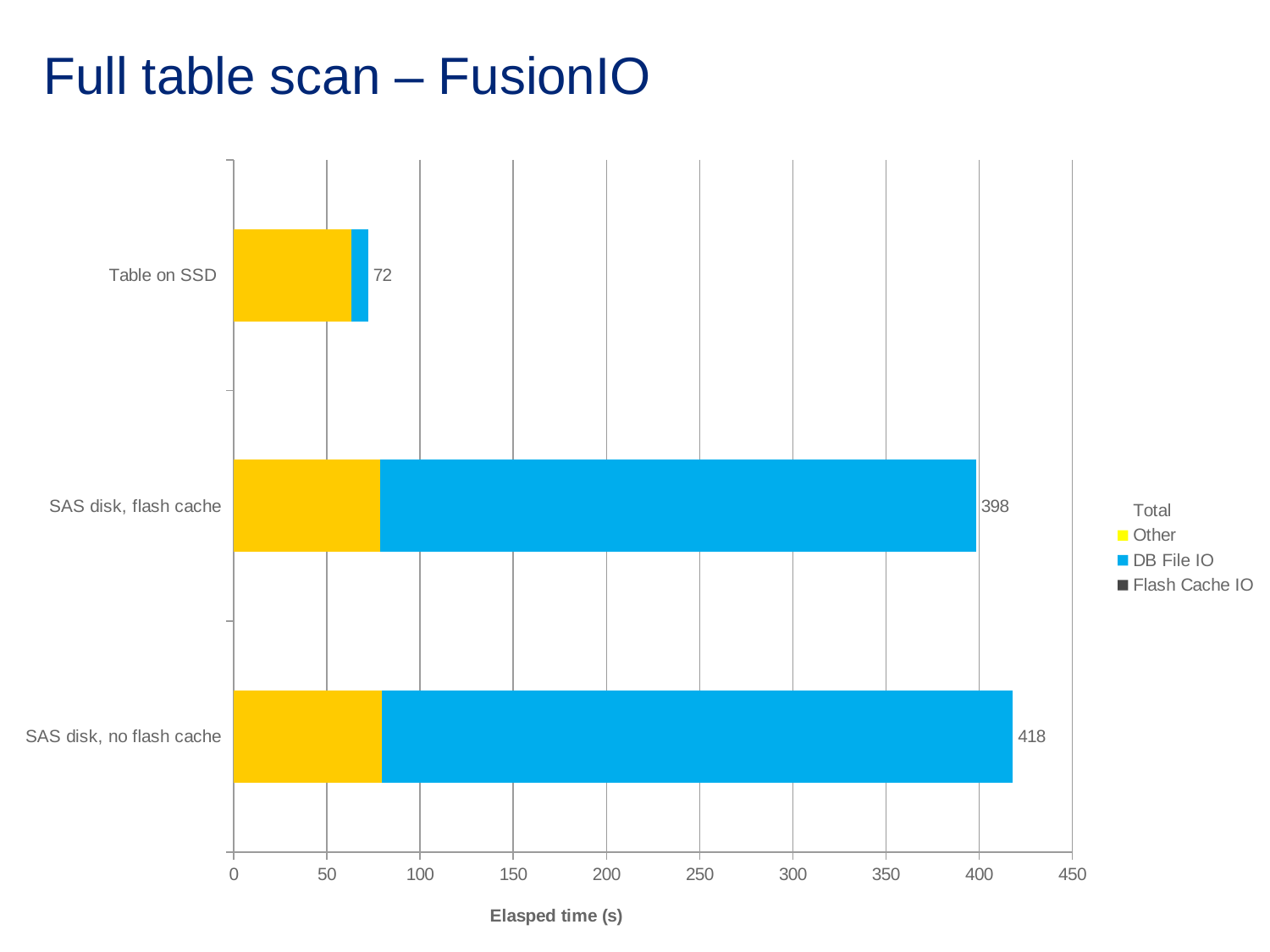
What is the difference in total elapsed time between "SAS disk, no flash cache" and "SAS disk, flash cache"? 20 Which category has the highest total elapsed time? SAS disk, no flash cache What is the total elapsed time for "Table on SSD"? 72 What is the total elapsed time for "SAS disk, no flash cache"? 418 What kind of chart is shown on the slide? Stacked bar chart Which category has the lowest total elapsed time? Table on SSD What is the total elapsed time for "SAS disk, flash cache"? 398 What is the difference in total elapsed time between "SAS disk, flash cache" and "Table on SSD"? 326 How many categories are shown on the chart? 3 Which has a larger total elapsed time, "Table on SSD" or "SAS disk, flash cache"? SAS disk, flash cache What is the label of the horizontal axis? Elasped time (s)